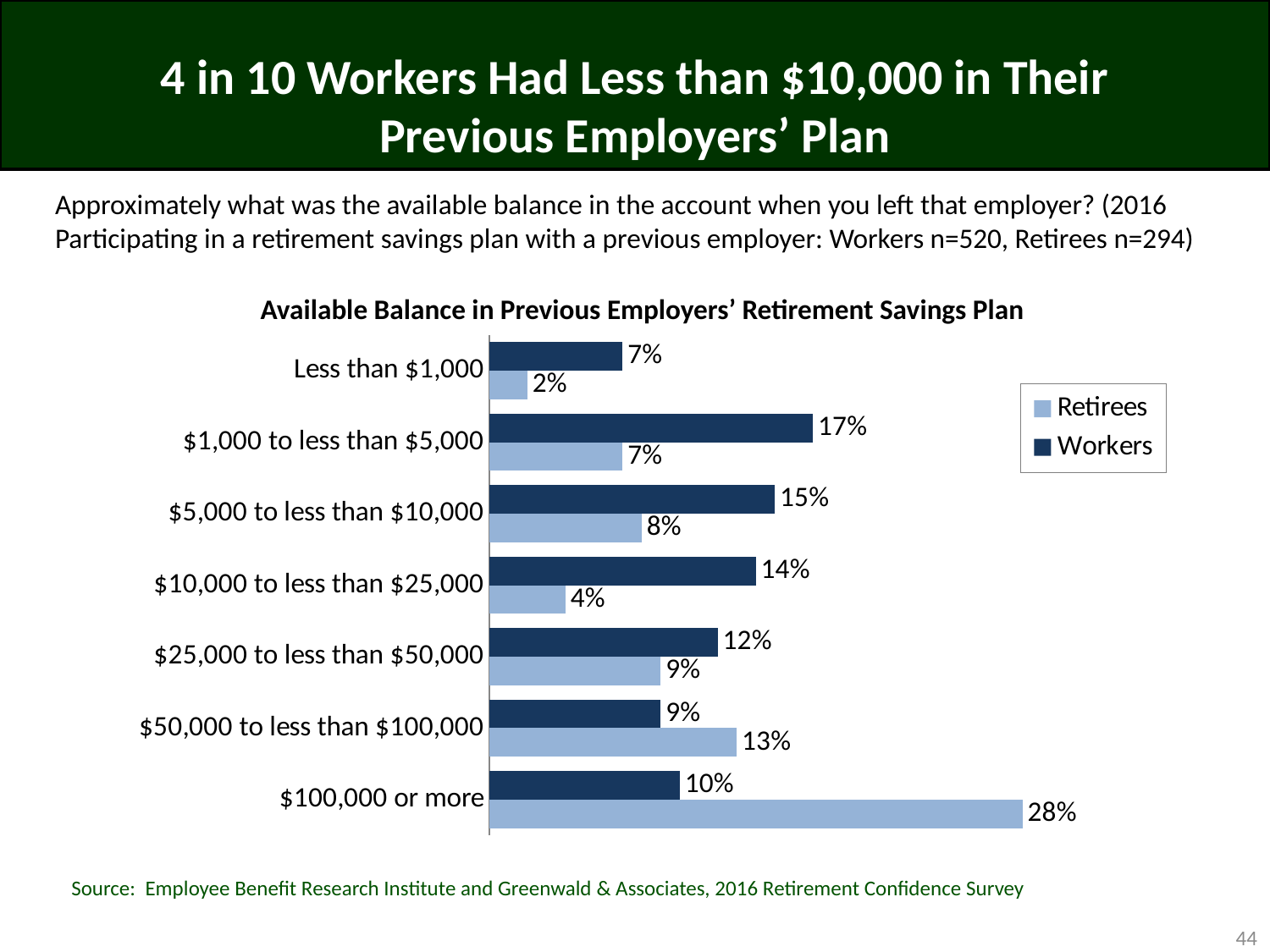
Which series is shown in the darker blue colour? Workers What percentage of Workers had $1,000 to less than $5,000 in their previous employers' plan? 17% Which balance category has the lowest value for Workers? Less than $1,000 How many series does the legend list? 2 Which balance category has the highest value for Retirees? $100,000 or more What percentage of Retirees had $100,000 or more in their previous employers' plan? 28% What is the title of the chart? Available Balance in Previous Employers' Retirement Savings Plan What is the difference between the Workers and Retirees values for $10,000 to less than $25,000? 10% What kind of chart is shown on the slide? Bar chart What percentage of Retirees had less than $1,000 in their previous employers' plan? 2% How many balance categories are shown on the chart? 7 For $50,000 to less than $100,000, which group has the larger value, Workers or Retirees? Retirees